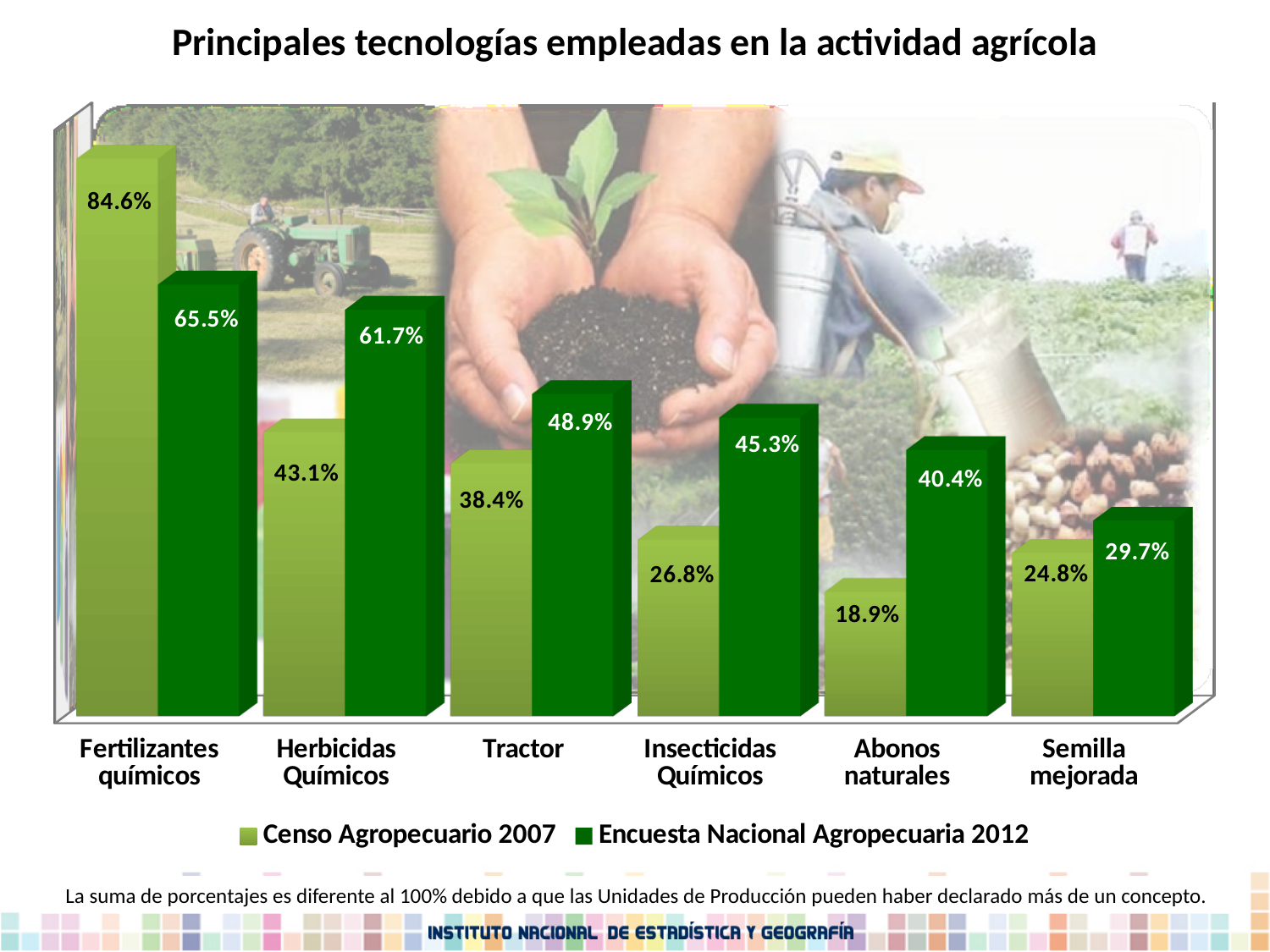
What is the difference between the Encuesta Nacional Agropecuaria 2012 and Censo Agropecuario 2007 values for Tractor? 10.5% Which category has the highest value in the Encuesta Nacional Agropecuaria 2012 series? Fertilizantes químicos Which category has the lowest value in the Censo Agropecuario 2007 series? Abonos naturales What is the value for Herbicidas Químicos in the Encuesta Nacional Agropecuaria 2012 series? 61.7% What is the value for Abonos naturales in the Censo Agropecuario 2007 series? 18.9% How many categories are shown on the x axis? 6 How many series does the legend list? 2 Which is larger for Fertilizantes químicos: the Censo Agropecuario 2007 value or the Encuesta Nacional Agropecuaria 2012 value? Censo Agropecuario 2007 What is the value for Fertilizantes químicos in the Censo Agropecuario 2007 series? 84.6% What is the title of the chart? Principales tecnologías empleadas en la actividad agrícola What kind of chart is shown on the slide? Bar chart What is the difference between the Encuesta Nacional Agropecuaria 2012 and Censo Agropecuario 2007 values for Abonos naturales? 21.5%